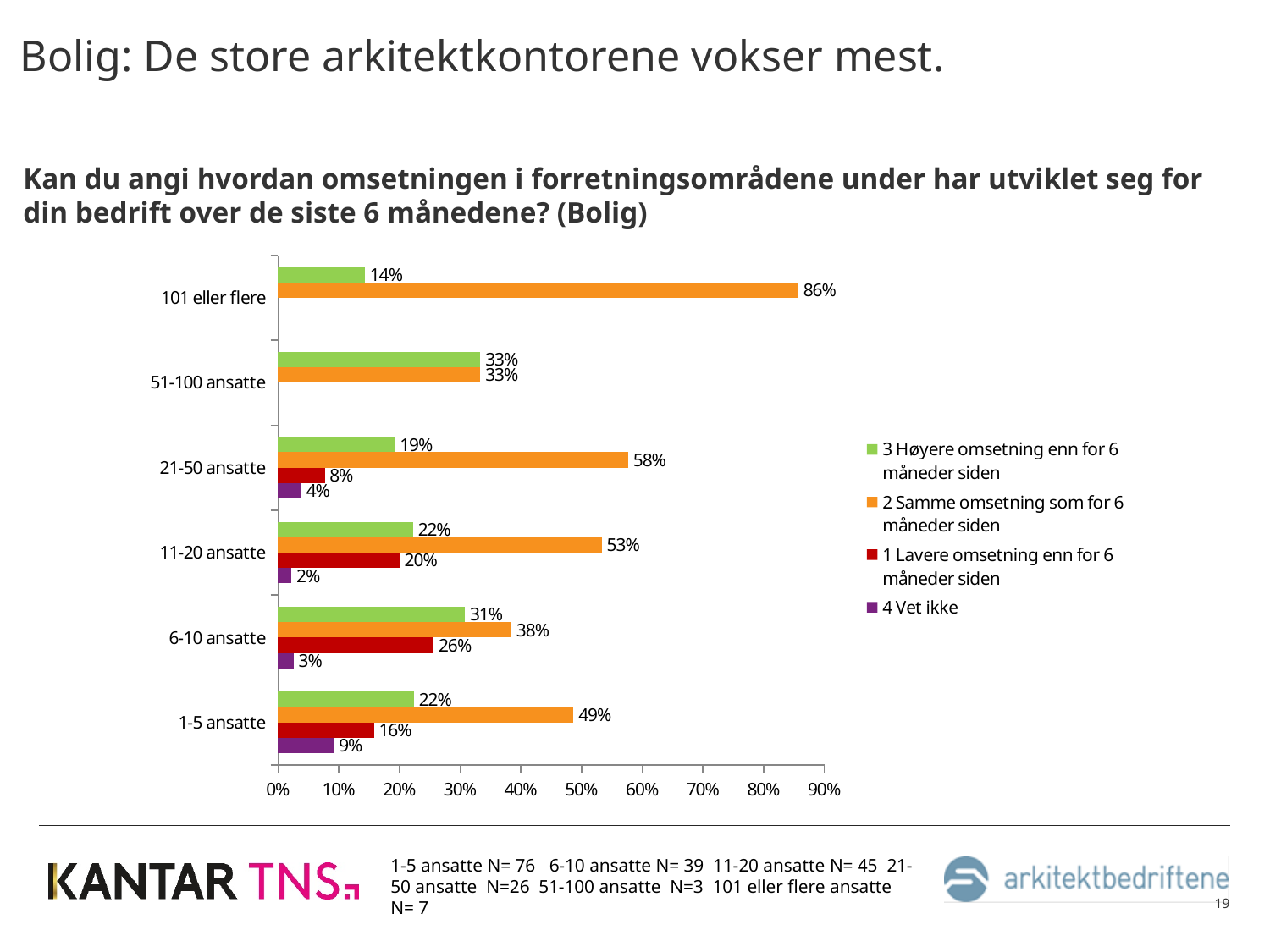
Which category has the lowest value for '4 Vet ikke' among those with a labelled value? 11-20 ansatte Which series is shown in orange in the legend? 2 Samme omsetning som for 6 måneder siden How many company-size categories are shown on the chart? 6 Which is larger: the '1 Lavere omsetning enn for 6 måneder siden' value for '6-10 ansatte' or for '1-5 ansatte'? 6-10 ansatte How many series does the legend list? 4 What is the value for '2 Samme omsetning som for 6 måneder siden' for '101 eller flere'? 86% What is the value for '3 Høyere omsetning enn for 6 måneder siden' for '6-10 ansatte'? 31% What is the difference between the '2 Samme omsetning som for 6 måneder siden' values for '21-50 ansatte' and '11-20 ansatte'? 5% Which category has the highest value for '2 Samme omsetning som for 6 måneder siden'? 101 eller flere What is the value for '4 Vet ikke' for '1-5 ansatte'? 9% What is the value for '1 Lavere omsetning enn for 6 måneder siden' for '11-20 ansatte'? 20% What kind of chart is shown on the slide? bar chart